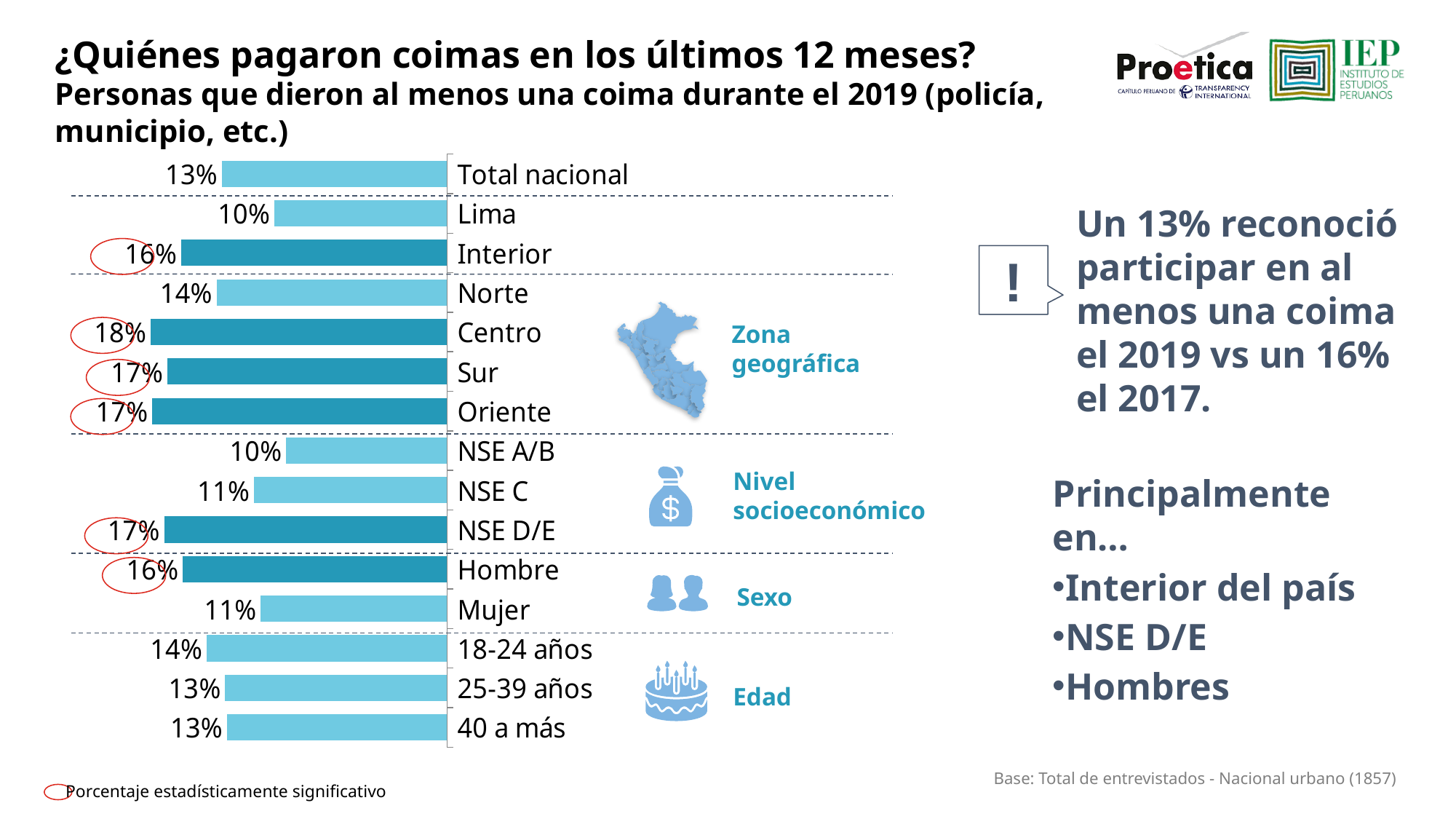
What is the difference between the values for Hombre and Mujer? 5% What is the value for Total nacional? 13% Which category has the highest value in the chart? Centro What is the difference between the values for Interior and Lima? 6% How many categories are plotted in the chart? 15 What is the value for Mujer? 11% What is the value for NSE D/E? 17% Among the zona geográfica categories (Norte, Centro, Sur, Oriente), which has the lowest value? Norte What is the value for Lima? 10% What kind of chart is shown on the slide? Bar chart Which category is labelled with the cake icon and the heading 'Edad'? 18-24 años, 25-39 años, 40 a más Which is larger, the value for NSE C or the value for NSE D/E? NSE D/E